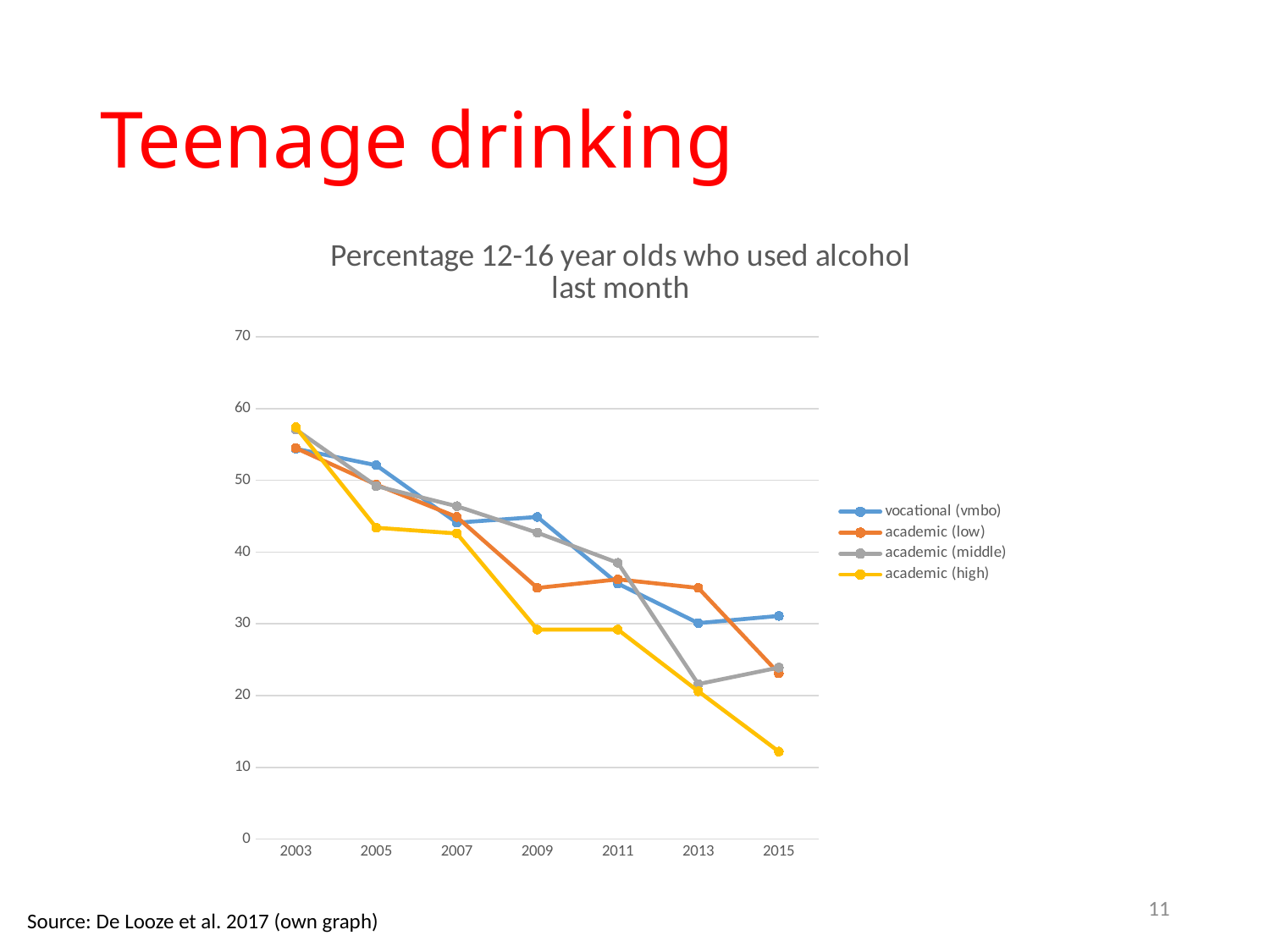
How many years are plotted along the x axis? 7 Which series has the lowest value in 2015? academic (high) In 2009, which is larger: vocational (vmbo) or academic (high)? vocational (vmbo) Does the academic (high) series rise or fall from 2003 to 2015? fall Is the value for academic (middle) in 2013 greater or less than 30? less How many series does the legend list? 4 Is the value for academic (high) in 2015 greater or less than 20? less Is the value for vocational (vmbo) in 2003 greater or less than 50? greater What kind of chart is shown on the slide? line chart Which series has the highest value in 2013? academic (low) Which series has the highest value in 2015? vocational (vmbo) What is the title of the chart? Percentage 12-16 year olds who used alcohol last month